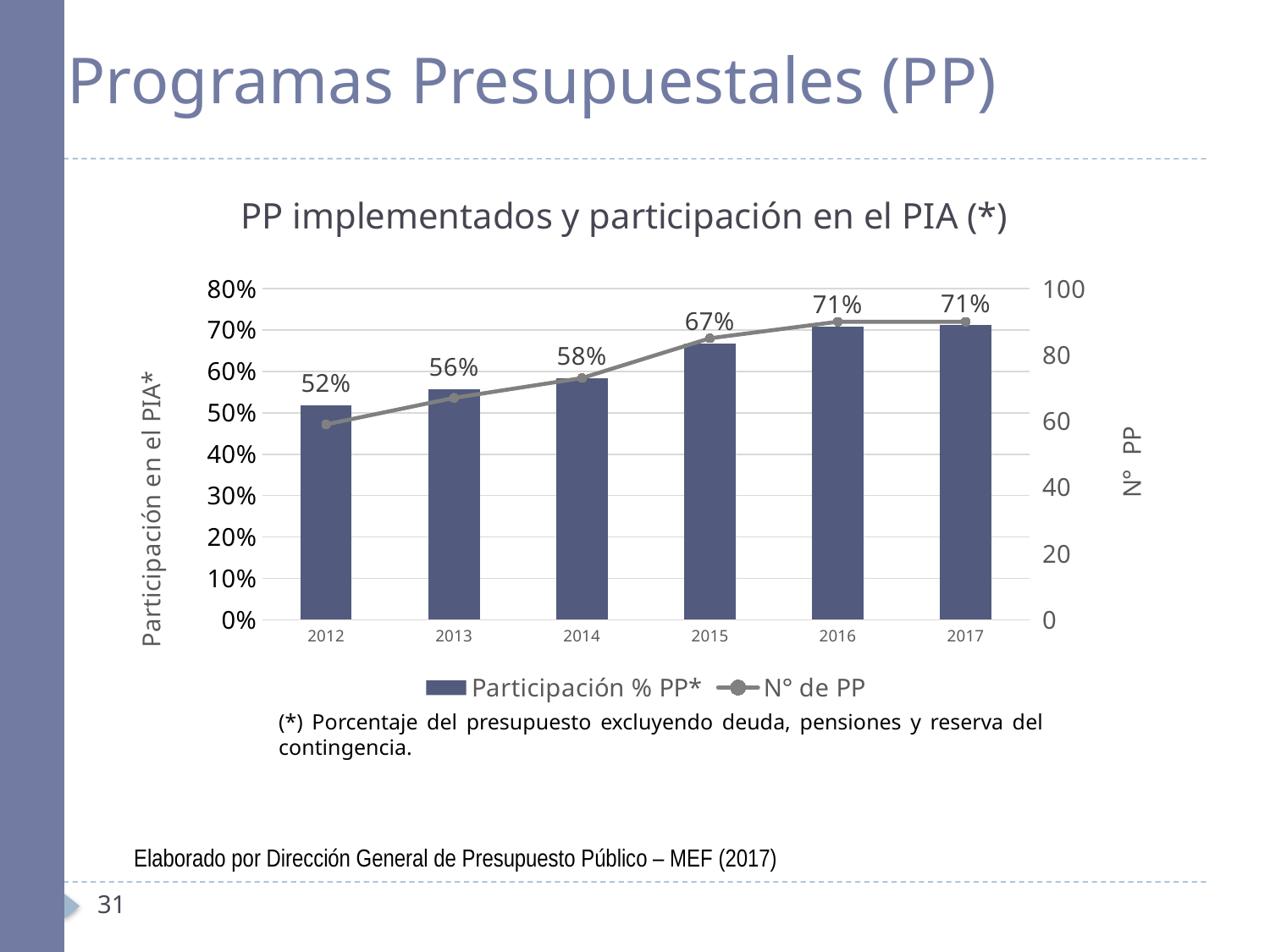
What is the Participación % PP* value for 2014? 58% Is the N° de PP value for 2015 greater or less than 80? greater What is the Participación % PP* value for 2012? 52% How many years are shown on the x axis? 6 Which year has the lowest Participación % PP* value? 2012 What is the Participación % PP* value for 2015? 67% Is the N° de PP value for 2012 greater or less than 40? greater Which is larger, the Participación % PP* value for 2014 or for 2016? 2016 Does the Participación % PP* value rise or fall from 2012 to 2017? rise How many series does the legend list? 2 What is the title of the chart? PP implementados y participación en el PIA (*) What is the difference between the Participación % PP* values for 2015 and 2013? 11%